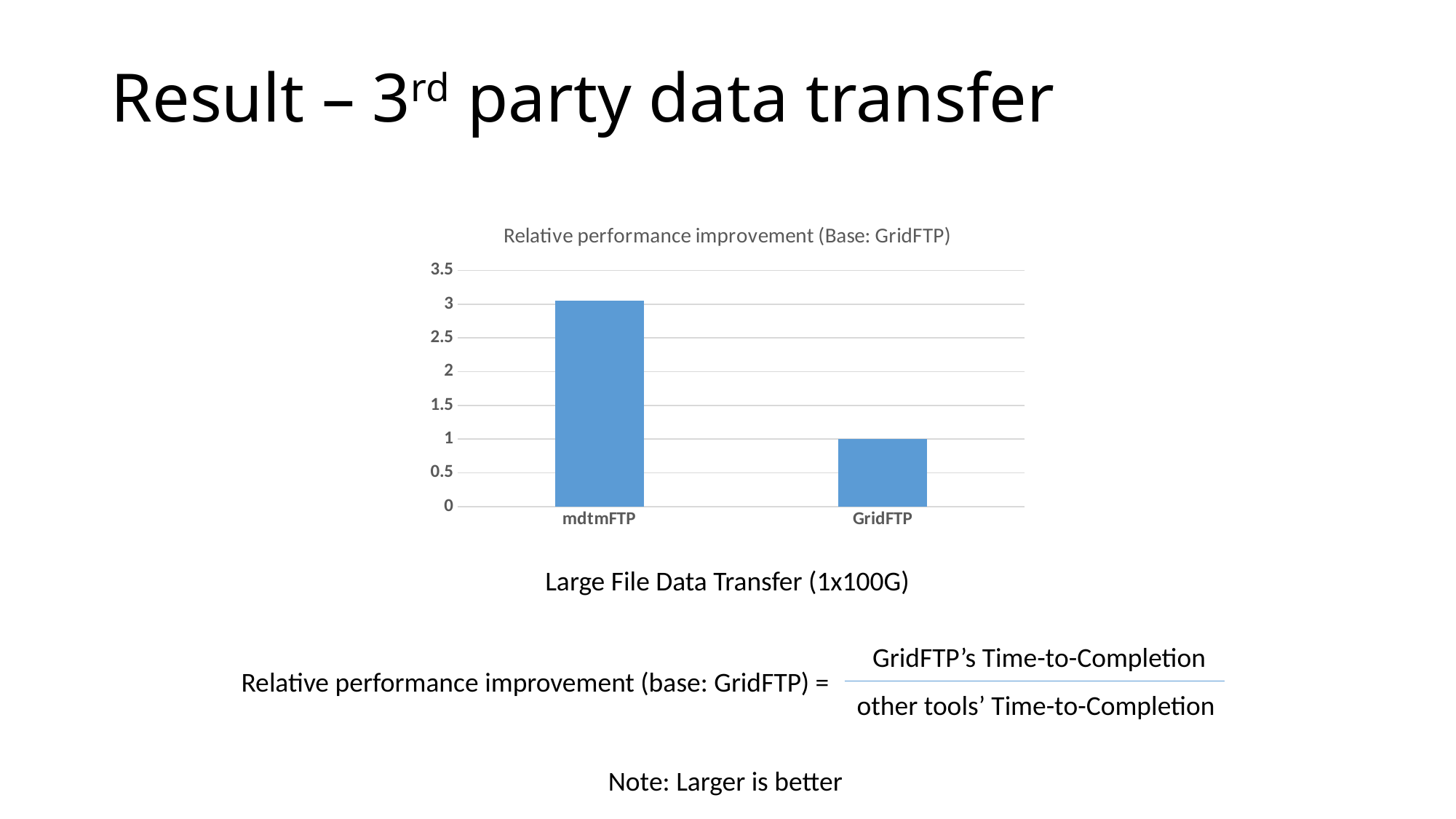
What kind of chart is shown on the slide? bar chart Is the value for GridFTP greater or less than 2? less Is the value for mdtmFTP greater or less than 3.5? less What is the title of the chart? Relative performance improvement (Base: GridFTP) Which category has the lowest relative performance improvement? GridFTP What is the highest tick value shown on the y axis? 3.5 How many categories are plotted in the chart? 2 Which category has the highest relative performance improvement? mdtmFTP What is the relative performance improvement value for GridFTP? 1 Do the bar values rise or fall from left to right along the x axis? fall Which has a larger value, mdtmFTP or GridFTP? mdtmFTP Is the value for mdtmFTP greater or less than 2? greater